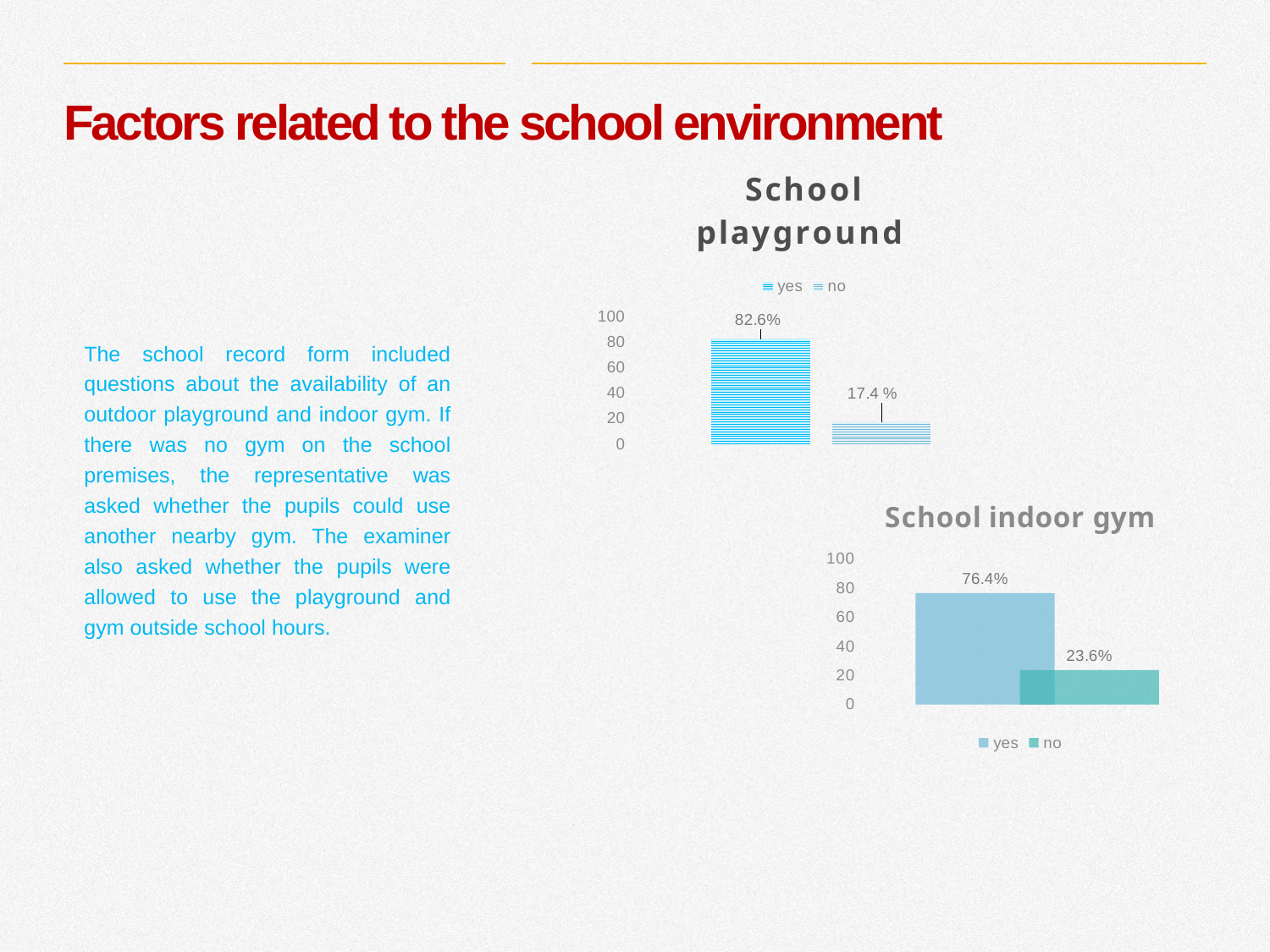
In the School indoor gym chart, what is the value for yes? 76.4% What kind of chart is the School indoor gym chart? bar chart In the School playground chart, what is the value for no? 17.4 % In the School indoor gym chart, is the value for yes greater or less than 60? greater In the School playground chart, what is the difference between the yes and no values? 65.2% In the School indoor gym chart, which series has the lowest value? no In the School playground chart, what is the value for yes? 82.6% How many series does the legend of the School playground chart list? 2 What is the title of the chart at the top right of the slide? School playground In the School playground chart, which series has the higher value, yes or no? yes In the School indoor gym chart, what is the value for no? 23.6% In the School indoor gym chart, what is the difference between the yes and no values? 52.8%